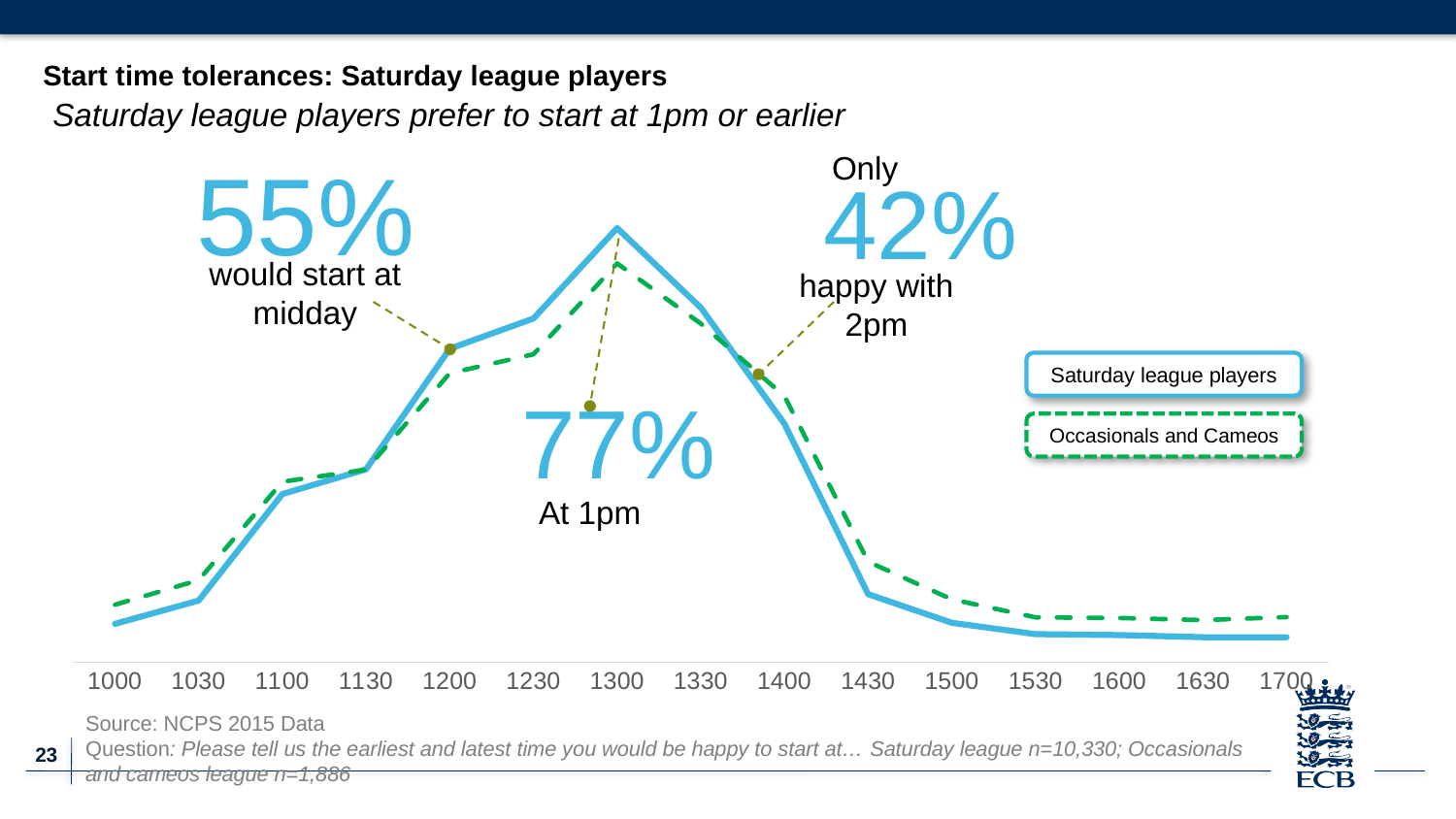
How many series does the legend list? 2 What percentage of Saturday league players are happy with a 2pm (1400) start? 42% At which start time does the Saturday league players line reach its highest point? 1300 What is the difference between the Saturday league players' value at 1300 and at 1200? 22 percentage points How many start times are shown along the x axis? 15 At 1500, which series has the higher value: Saturday league players or Occasionals and Cameos? Occasionals and Cameos What percentage of Saturday league players would start at midday (1200)? 55% What percentage of Saturday league players would be happy to start at 1pm (1300)? 77% Which series is drawn with a dashed green line? Occasionals and Cameos Do the values for Saturday league players rise or fall between 1300 and 1700? Fall What kind of chart is shown on the slide? Line chart Do the values for Saturday league players rise or fall between 1000 and 1300? Rise